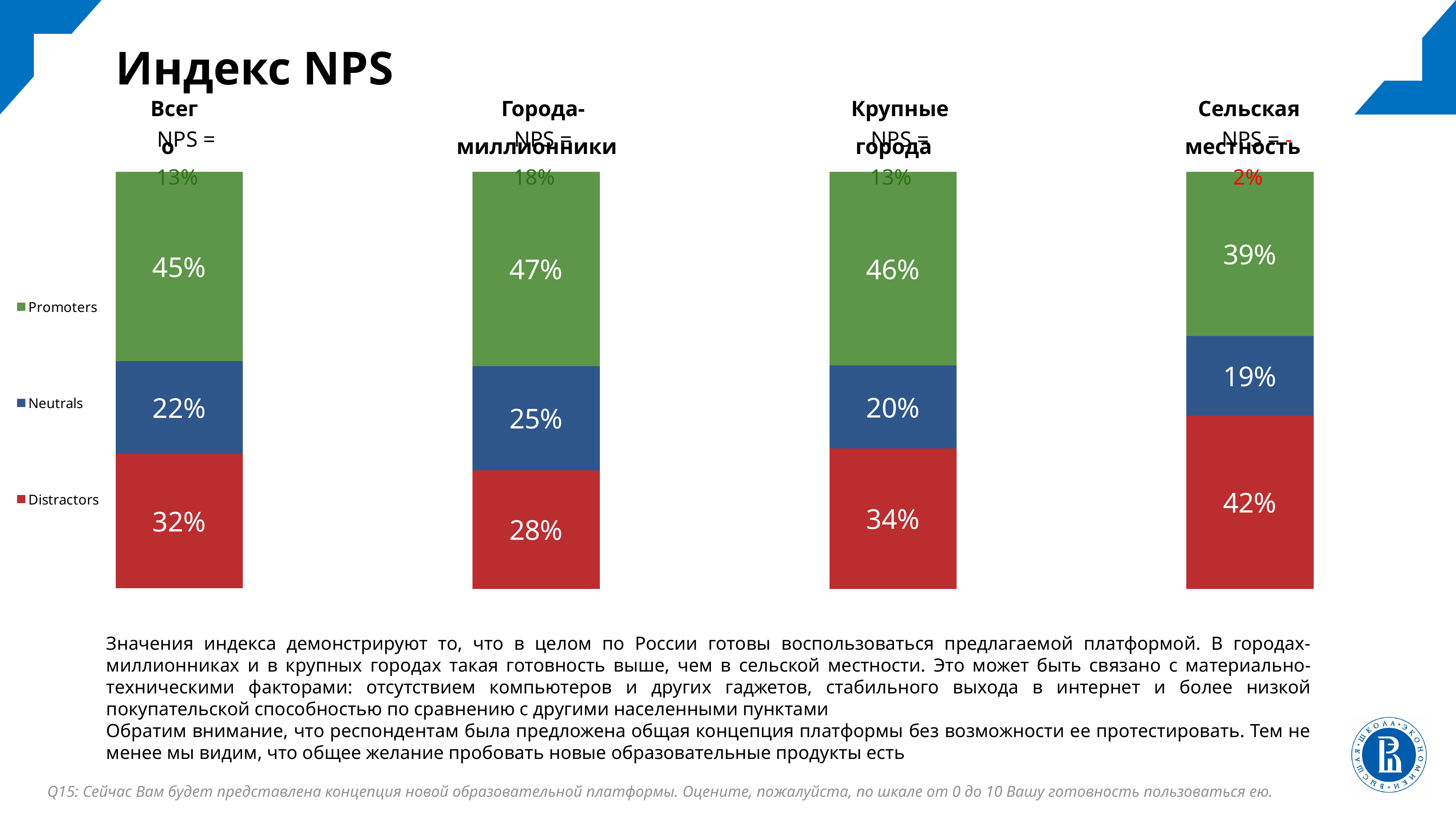
In the chart titled 'Города-миллионники', what is the value for Distractors? 28% What kind of chart is used on this slide? Stacked bar chart Which is larger in the chart titled 'Всего': Neutrals or Distractors? Distractors Which colour represents Promoters in the legend? Green In the chart titled 'Сельская местность', what is the value for Distractors? 42% In the chart titled 'Всего', what is the value for Promoters? 45% How many series does the legend list for these charts? 3 In the chart titled 'Крупные города', what is the difference between Promoters and Distractors? 12% In the chart titled 'Города-миллионники', which segment is the smallest? Neutrals How many stacked bars (regions) are shown on the slide? 4 In the chart titled 'Крупные города', what is the value for Neutrals? 20% In the chart titled 'Сельская местность', which segment is the largest? Distractors